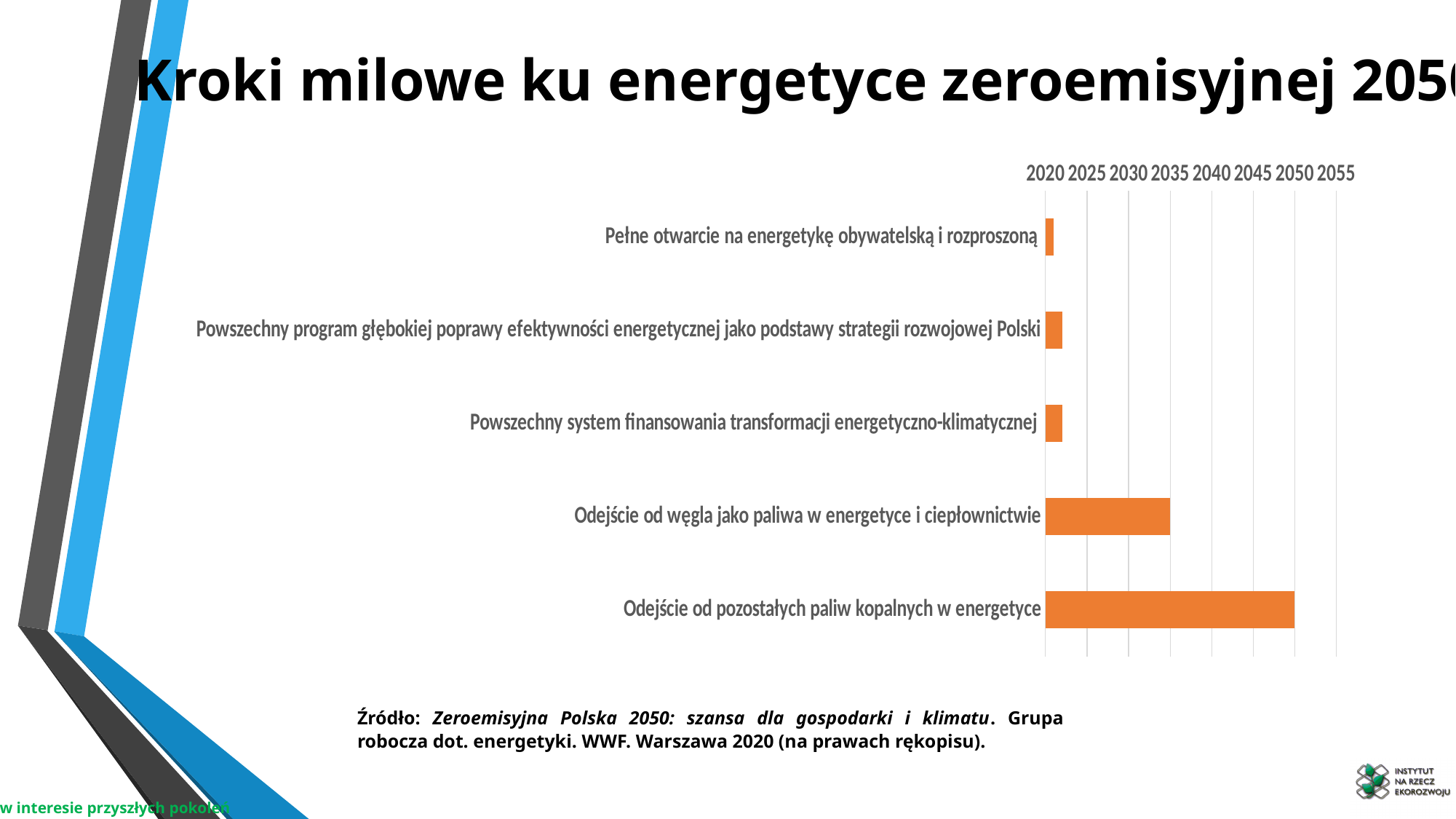
How many categories (milestones) are plotted in the chart? 5 Does the bar for "Odejście od węgla jako paliwa w energetyce i ciepłownictwie" end before or after 2040? before Which category has the longest bar in the chart? Odejście od pozostałych paliw kopalnych w energetyce What colour are the bars in the chart? orange Does the bar for "Odejście od pozostałych paliw kopalnych w energetyce" end before or after 2045? after Does the bar for "Pełne otwarcie na energetykę obywatelską i rozproszoną" end before or after 2025? before What is the first year shown on the chart's axis? 2020 What kind of chart is shown on the slide? bar chart How many years separate the end of the bar for "Odejście od węgla jako paliwa w energetyce i ciepłownictwie" (2035) from the end of the bar for "Odejście od pozostałych paliw kopalnych w energetyce" (2050)? 15 In which year does the bar for "Odejście od pozostałych paliw kopalnych w energetyce" end? 2050 In which year does the bar for "Odejście od węgla jako paliwa w energetyce i ciepłownictwie" end? 2035 Which bar extends further along the axis: "Odejście od węgla jako paliwa w energetyce i ciepłownictwie" or "Odejście od pozostałych paliw kopalnych w energetyce"? Odejście od pozostałych paliw kopalnych w energetyce